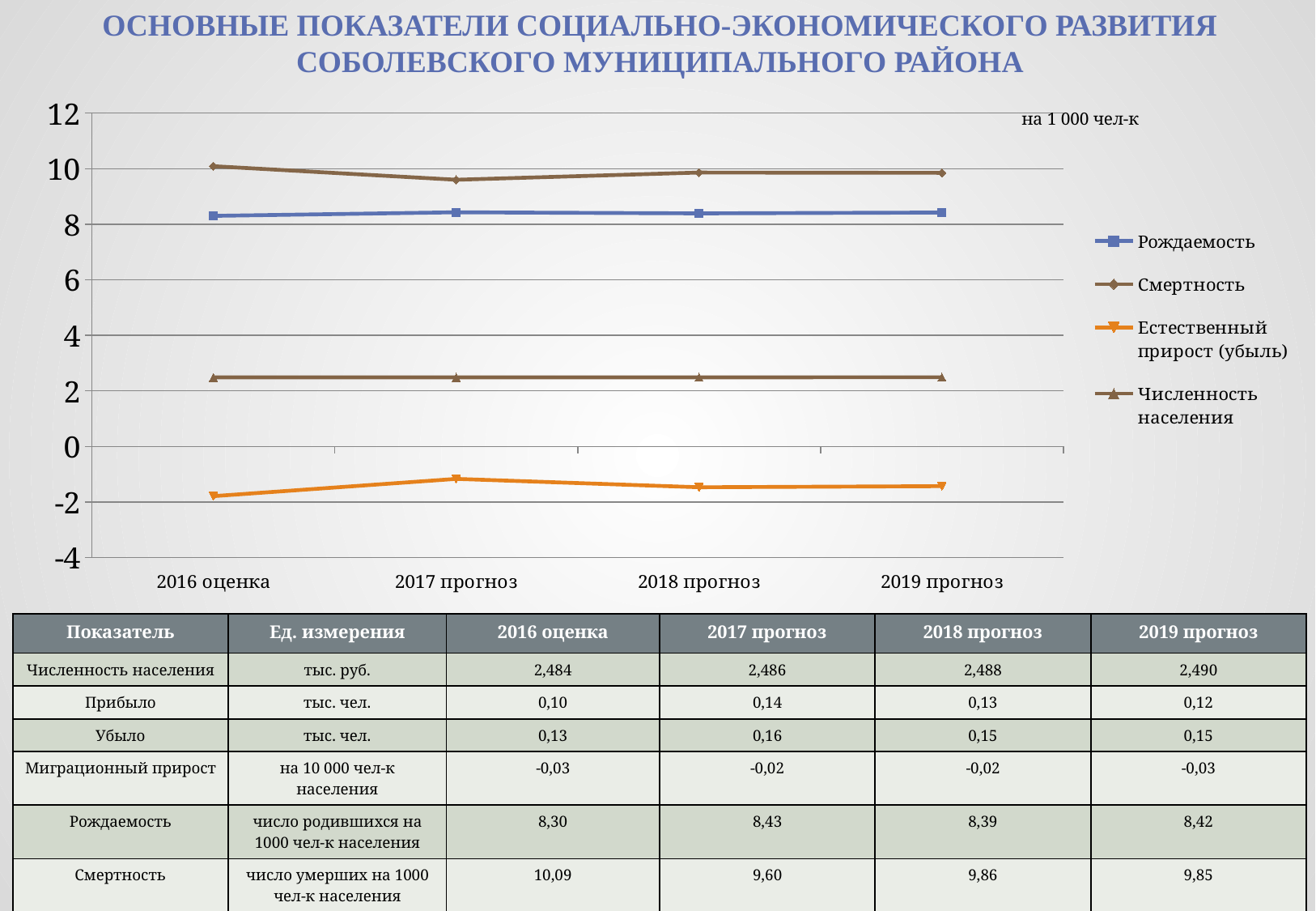
How many points are there along the x axis of the chart? 4 Which is larger in 2019 прогноз, Рождаемость or Смертность? Смертность Does the Смертность line rise or fall from 2016 оценка to 2017 прогноз? fall What is the difference between Смертность in 2016 оценка and 2017 прогноз? 0,49 Is the value for Смертность in 2017 прогноз greater or less than 8? greater Is the value for Естественный прирост (убыль) in 2016 оценка greater or less than 0? less How many series does the chart legend list? 4 What is the value of Рождаемость for 2017 прогноз? 8,43 Which series has the lowest values on the chart? Естественный прирост (убыль) What kind of chart is shown on the slide? line chart What is the value of Смертность for 2016 оценка? 10,09 Which series has the highest values on the chart? Смертность